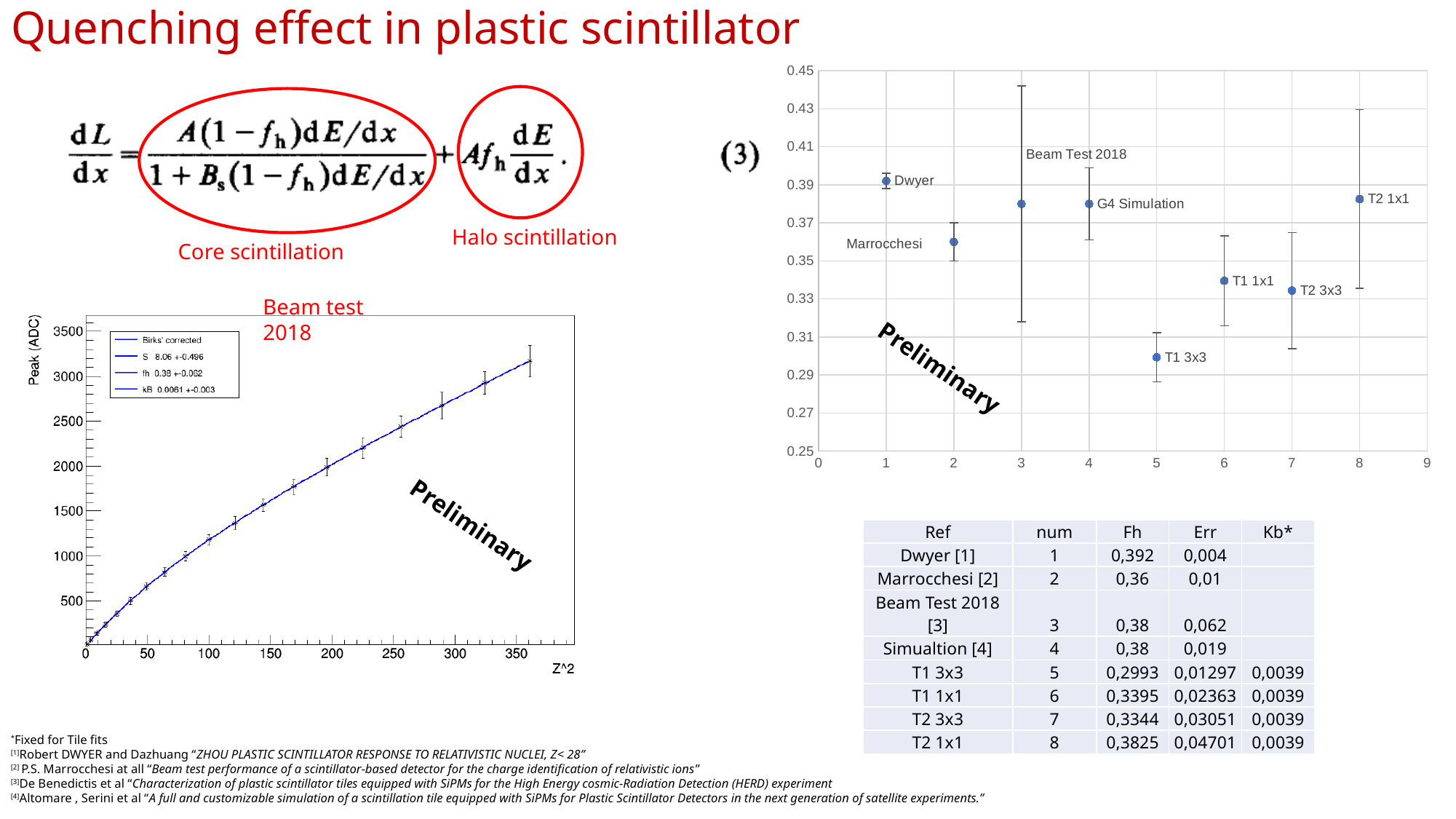
On the right-hand chart, which labelled point has the highest Fh value? Dwyer On the right-hand chart, what is the Fh value plotted for Dwyer (point 1)? 0,392 What kind of chart is the left-hand chart (Peak (ADC) versus Z^2)? Line chart with data points and error bars On the right-hand chart, is the value for T1 3x3 greater or less than 0.31? less On the right-hand chart, what is the Fh value plotted for T2 1x1 (point 8)? 0,3825 On the left-hand chart, does Peak (ADC) rise or fall as Z^2 increases? Rises What is the label of the x axis on the left-hand chart? Z^2 On the right-hand chart, what is the Fh value plotted for T1 3x3 (point 5)? 0,2993 On the right-hand chart, what is the difference between the Fh values of Dwyer and Marrocchesi? 0,032 On the right-hand chart, which labelled point has the lowest Fh value? T1 3x3 On the right-hand chart, which has the larger Fh value, T2 1x1 or T2 3x3? T2 1x1 How many data points are plotted on the right-hand chart? 8